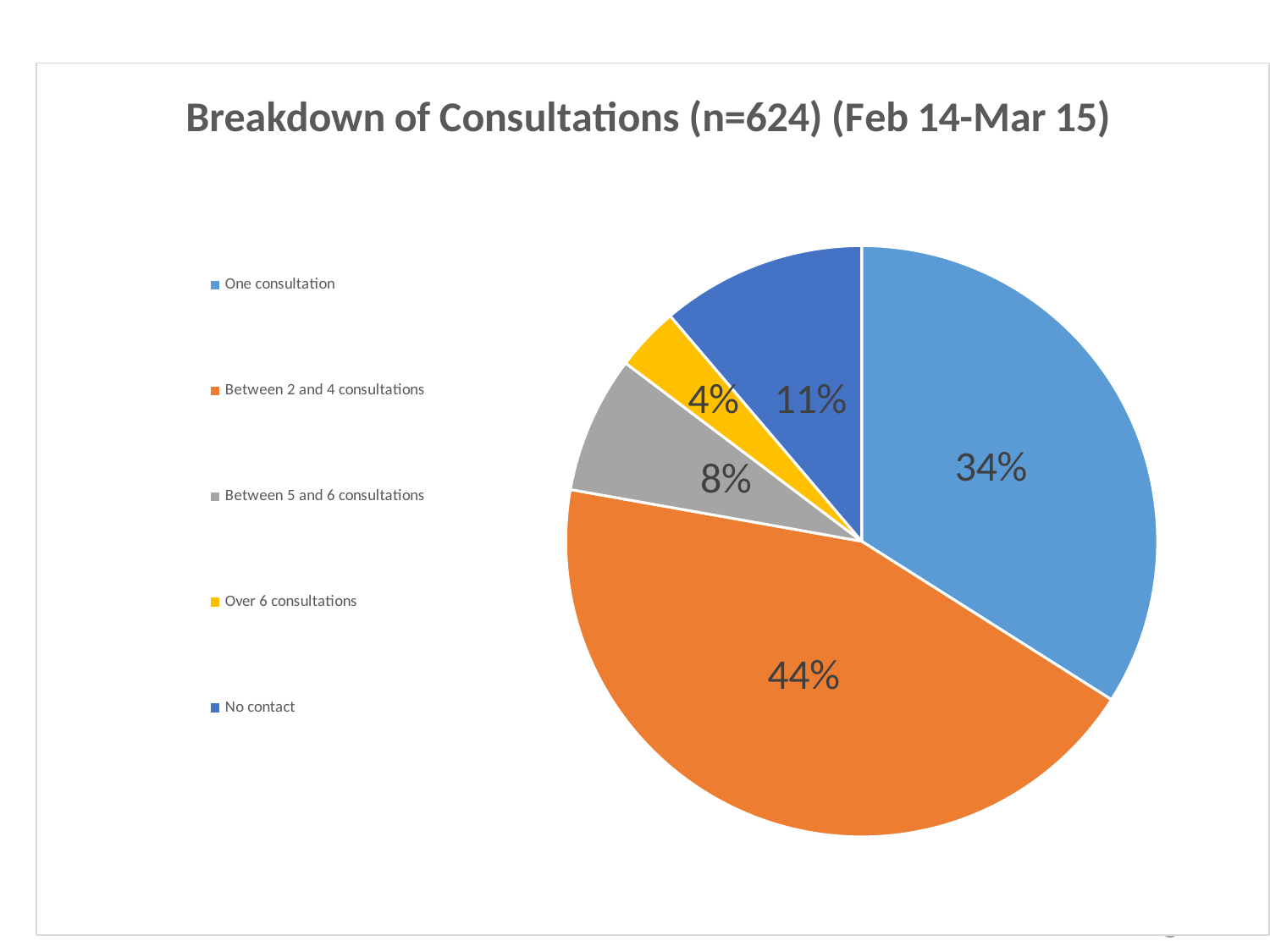
Which category has the largest slice of the pie? Between 2 and 4 consultations What kind of chart is shown on the slide? Pie chart Which category has the smallest slice of the pie? Over 6 consultations What is the difference in percentage points between 'Between 2 and 4 consultations' and 'One consultation'? 10 Which is larger, 'No contact' or 'Between 5 and 6 consultations'? No contact What share of the pie does 'Between 2 and 4 consultations' represent? 44% What is the value shown for 'Between 5 and 6 consultations'? 8% What is the value shown for 'No contact'? 11% What share of the pie does 'One consultation' represent? 34% What is the value shown for 'Over 6 consultations'? 4% What is the title of the chart? Breakdown of Consultations (n=624) (Feb 14-Mar 15) How many categories does the pie chart show? 5